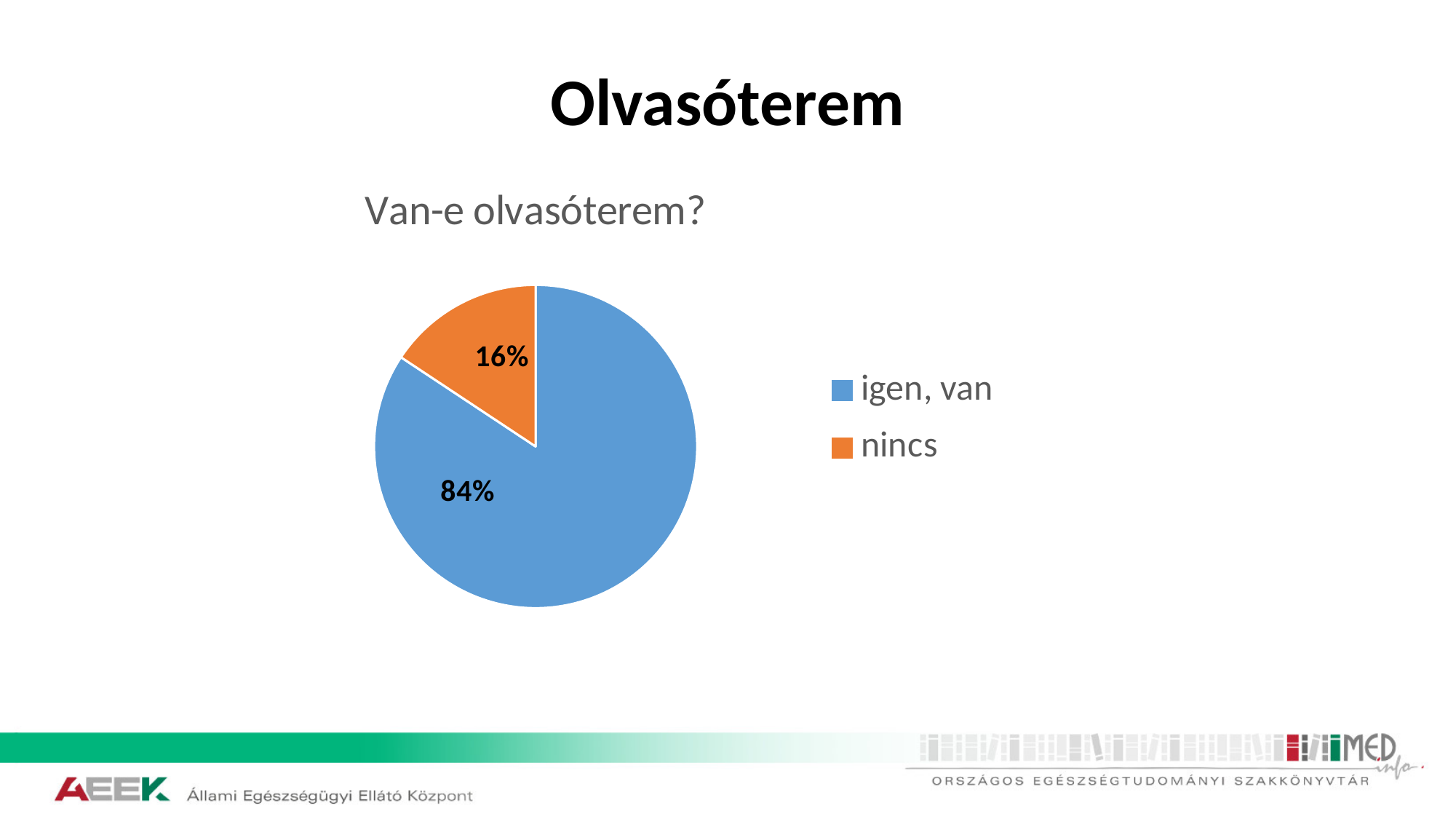
How many categories are shown in the pie chart? 2 What is the title of the chart? Van-e olvasóterem? What colour is the "nincs" slice in the pie chart? orange Which is larger, the "igen, van" slice or the "nincs" slice? igen, van What share of the pie does the "nincs" slice represent? 16% What share of the pie does the "igen, van" slice represent? 84% What kind of chart is shown on the slide? pie chart Is the share for "igen, van" greater or less than 50%? greater Which category has the smallest slice of the pie? nincs What is the difference in percentage points between the "igen, van" and "nincs" slices? 68 Which category has the largest slice of the pie? igen, van